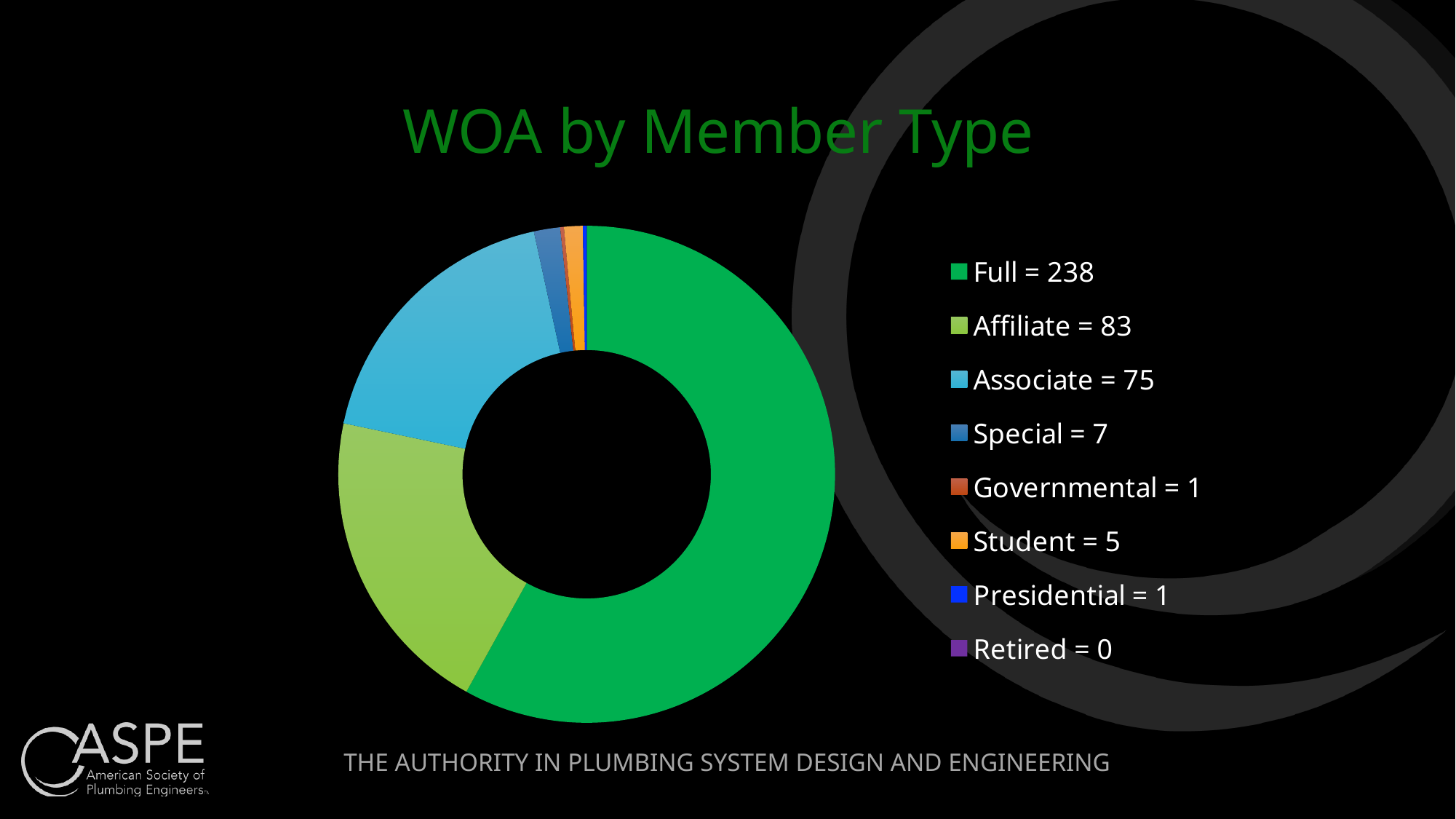
Which is larger, the value for Special or the value for Student? Special What is the title of the chart? WOA by Member Type How many member types are listed in the chart's legend? 8 What is the value for Full in the WOA by Member Type chart? 238 What is the value for Student in the chart? 5 What kind of chart is shown on the slide? doughnut chart Which member type has the largest value in the chart? Full What is the difference between the Full and Affiliate values? 155 How many Associate members are shown in the chart? 75 What is the difference between the Affiliate and Associate values? 8 Which member type has the smallest value in the chart? Retired What share of the total do Full members represent? 58%